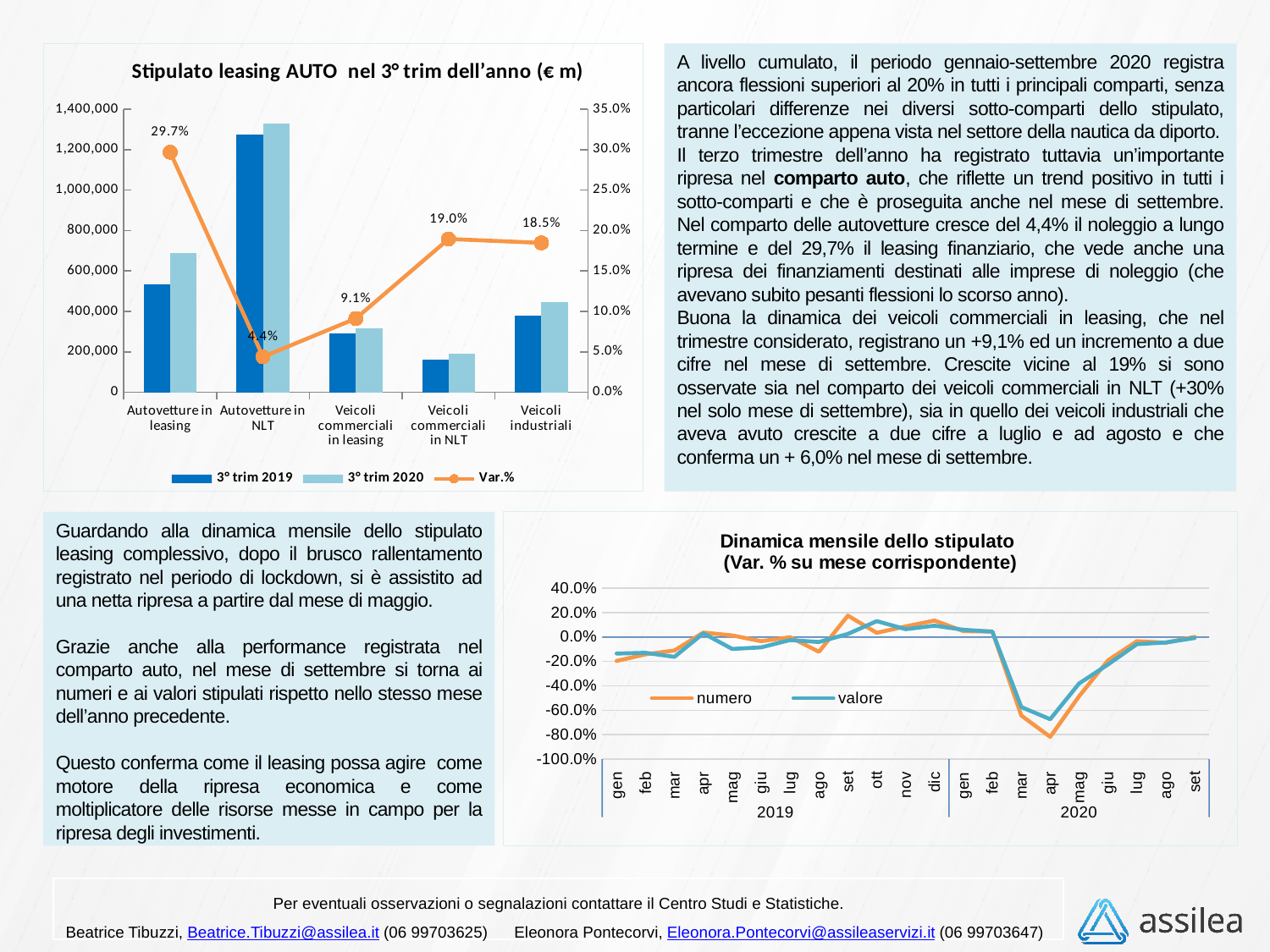
In the chart 'Stipulato leasing AUTO nel 3° trim dell'anno (€ m)', what is the Var.% for Veicoli commerciali in NLT? 19.0% In the chart 'Stipulato leasing AUTO nel 3° trim dell'anno (€ m)', how many categories are shown on the x axis? 5 In the chart 'Dinamica mensile dello stipulato (Var. % su mese corrispondente)', how many series does the legend list? 2 In the chart 'Stipulato leasing AUTO nel 3° trim dell'anno (€ m)', what is the Var.% for Veicoli industriali? 18.5% In the chart 'Stipulato leasing AUTO nel 3° trim dell'anno (€ m)', for Autovetture in leasing, which is larger: 3° trim 2019 or 3° trim 2020? 3° trim 2020 In the chart 'Stipulato leasing AUTO nel 3° trim dell'anno (€ m)', which category has the lowest Var.%? Autovetture in NLT In the chart 'Stipulato leasing AUTO nel 3° trim dell'anno (€ m)', is the 3° trim 2020 value for Autovetture in NLT greater or less than 1,000,000? greater In the chart 'Stipulato leasing AUTO nel 3° trim dell'anno (€ m)', which category has the highest Var.%? Autovetture in leasing In the chart 'Stipulato leasing AUTO nel 3° trim dell'anno (€ m)', what is the Var.% for Autovetture in leasing? 29.7% In the chart 'Stipulato leasing AUTO nel 3° trim dell'anno (€ m)', how many series does the legend list? 3 In the chart 'Stipulato leasing AUTO nel 3° trim dell'anno (€ m)', what is the difference in Var.% between Autovetture in leasing and Veicoli commerciali in leasing? 20.6 percentage points In the chart 'Stipulato leasing AUTO nel 3° trim dell'anno (€ m)', what is the Var.% for Autovetture in NLT? 4.4%